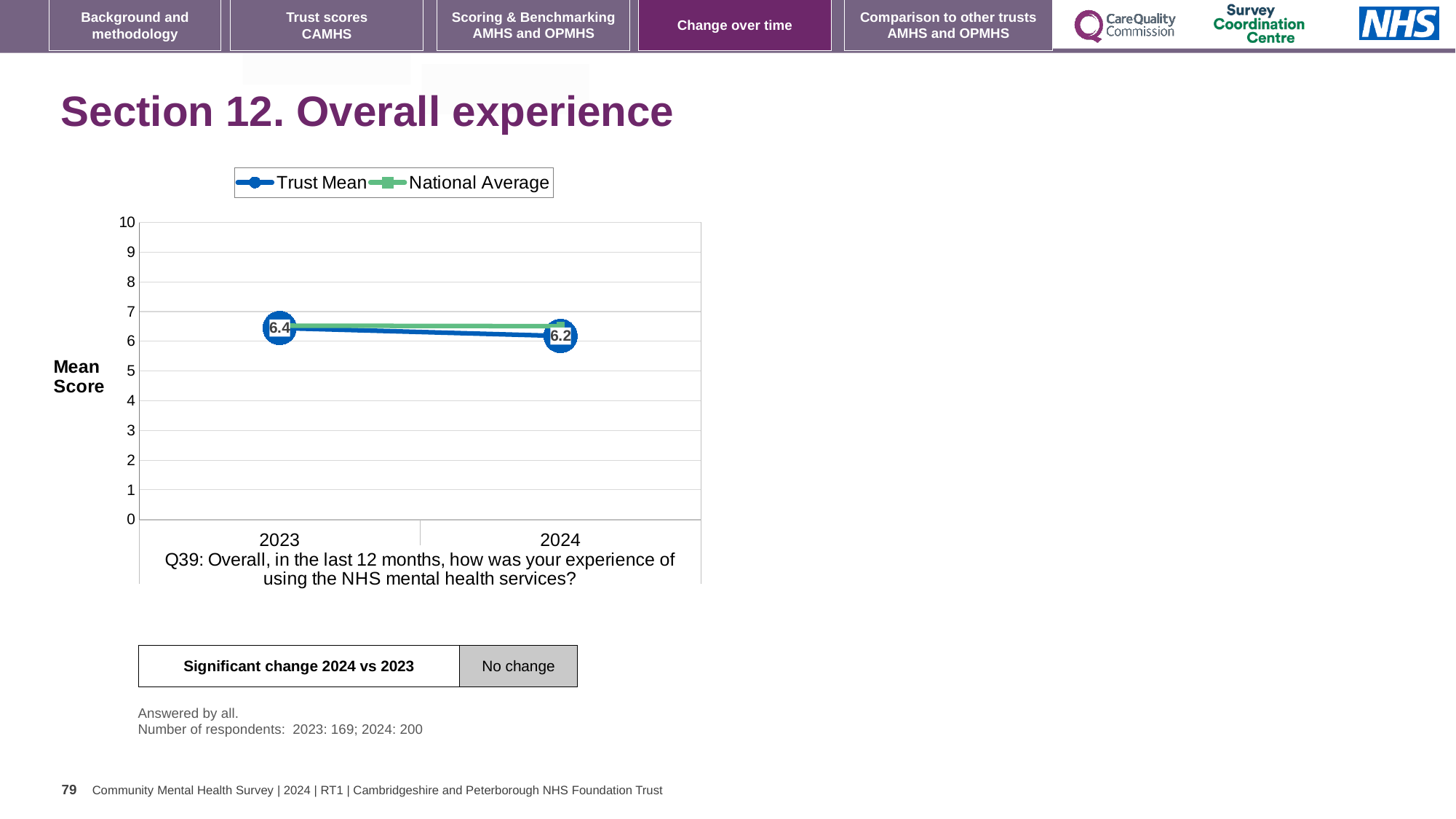
What is the label on the y axis of the chart? Mean Score By how much did the Trust Mean score change from 2023 to 2024? 0.2 What are the two series named in the legend? Trust Mean and National Average How many years are plotted on the x axis? 2 Is the Trust Mean value for 2023 greater or less than 7? less In which year is the Trust Mean score higher, 2023 or 2024? 2023 Does the Trust Mean rise or fall from 2023 to 2024? fall What is the Trust Mean score for 2024? 6.2 What kind of chart is shown on the slide? line chart What is the Trust Mean score for 2023? 6.4 How many series does the legend list? 2 Is the National Average value for 2024 greater or less than 5? greater